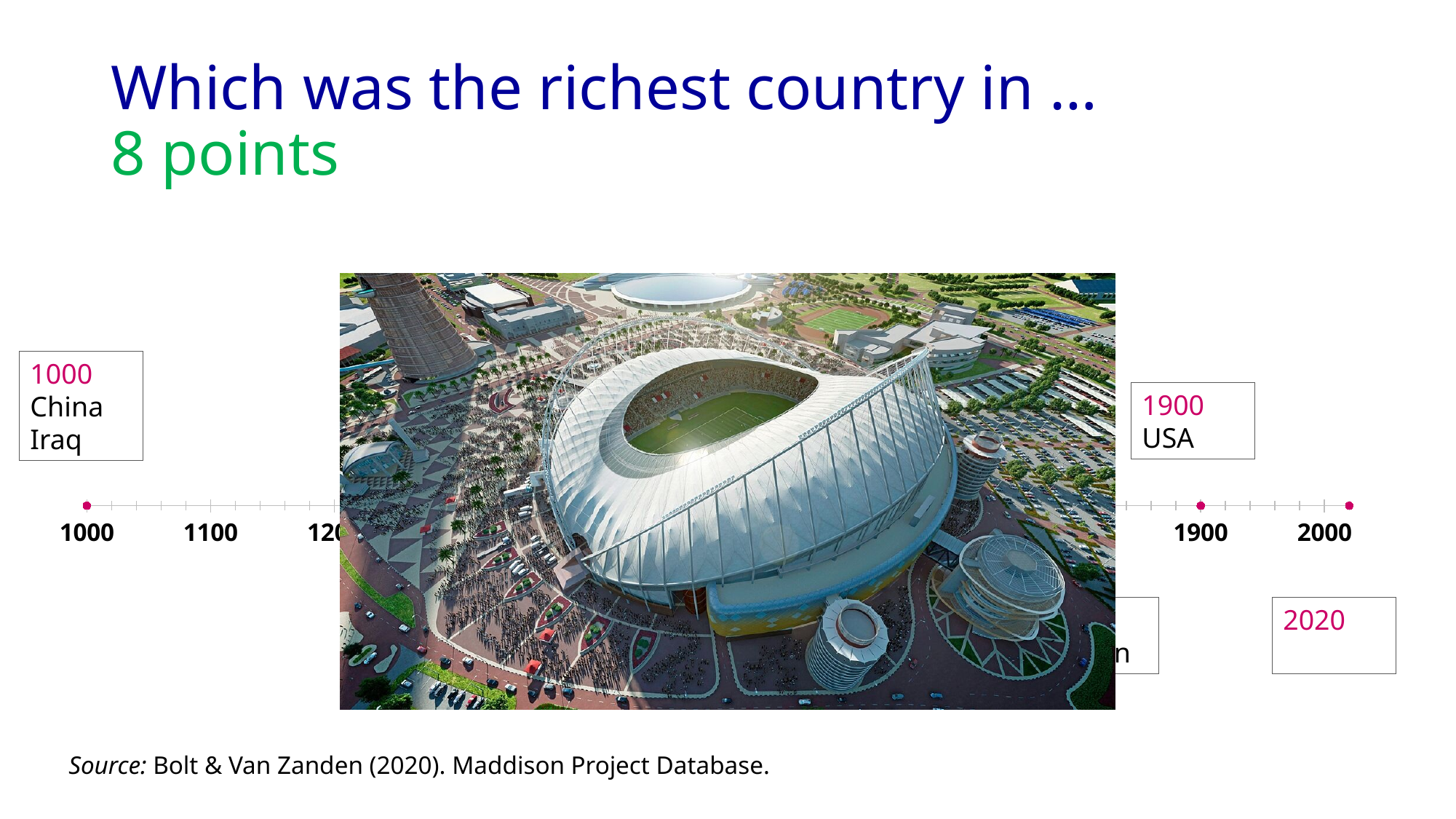
Is the 1900 marker on the timeline to the left or right of the 2000 tick? left What source is cited at the bottom of the slide? Bolt & Van Zanden (2020). Maddison Project Database. On the timeline, which countries are listed in the box for the year 1000? China and Iraq How many countries are listed in the box for the year 1000? 2 How many points is the question on the slide worth? 8 points What kind of visual is used to show the years on the slide? a timeline What is the latest year labelled in a box on the timeline? 2020 On the timeline, which country is shown as the richest in 1900? USA What is the earliest year marked with a point on the timeline? 1000